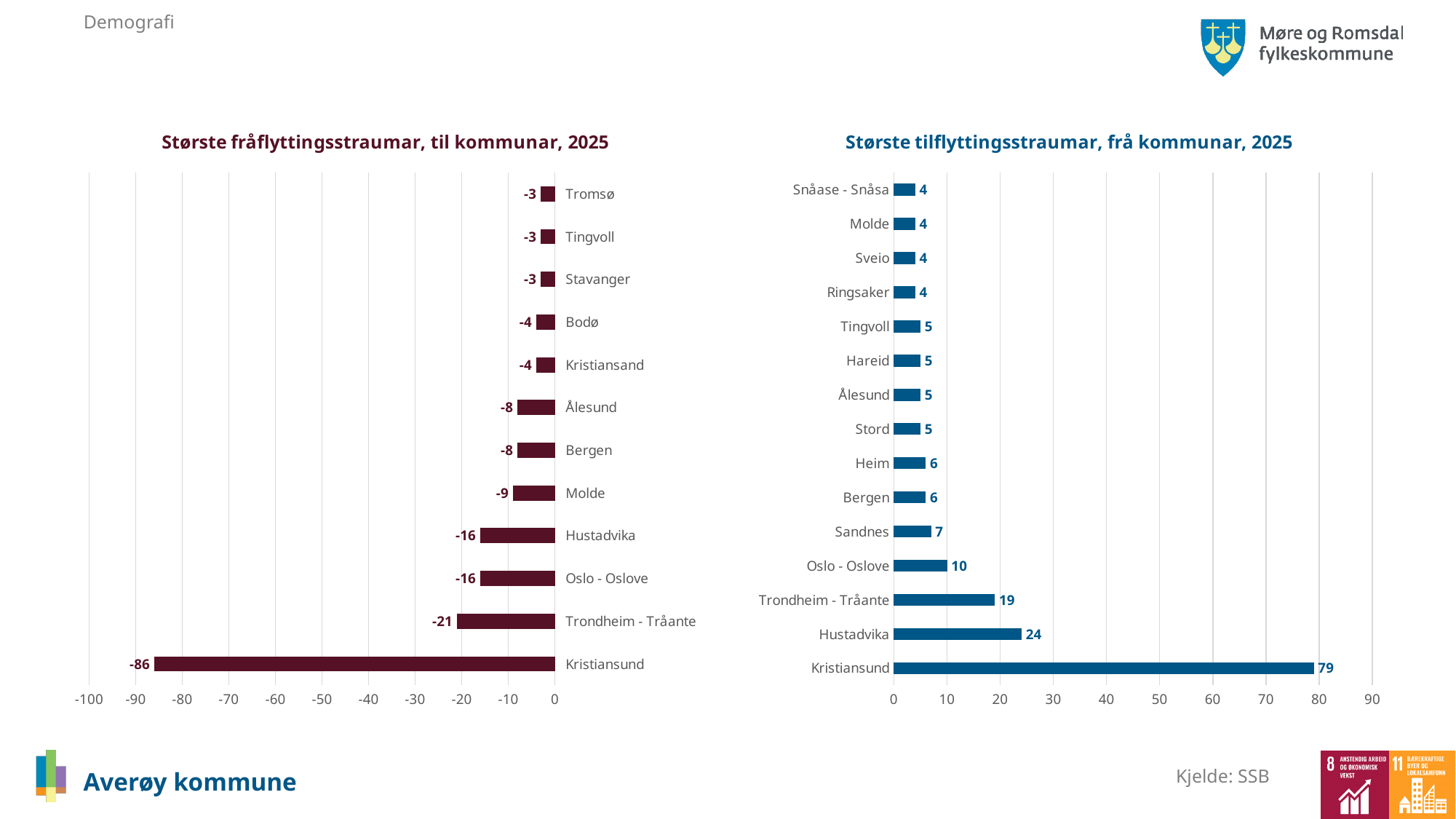
In the chart 'Største tilflyttingsstraumar, frå kommunar, 2025', what is the value for Hustadvika? 24 In the chart 'Største tilflyttingsstraumar, frå kommunar, 2025', is the value for Kristiansund greater or less than 70? greater What type of chart is 'Største tilflyttingsstraumar, frå kommunar, 2025'? Bar chart In the chart 'Største tilflyttingsstraumar, frå kommunar, 2025', what is the difference between the values for Kristiansund and Hustadvika? 55 In the chart 'Største tilflyttingsstraumar, frå kommunar, 2025', which has a larger value, Trondheim - Tråante or Oslo - Oslove? Trondheim - Tråante In the chart 'Største fråflyttingsstraumar, til kommunar, 2025', what is the value for Kristiansund? -86 In the chart 'Største tilflyttingsstraumar, frå kommunar, 2025', which municipality has the highest value? Kristiansund How many municipalities are shown in the chart 'Største fråflyttingsstraumar, til kommunar, 2025'? 12 How many municipalities are shown in the chart 'Største tilflyttingsstraumar, frå kommunar, 2025'? 15 In the chart 'Største fråflyttingsstraumar, til kommunar, 2025', which municipality has the lowest (most negative) value? Kristiansund In the chart 'Største fråflyttingsstraumar, til kommunar, 2025', what is the value for Oslo - Oslove? -16 In the chart 'Største fråflyttingsstraumar, til kommunar, 2025', what is the difference between the values for Trondheim - Tråante and Molde? 12